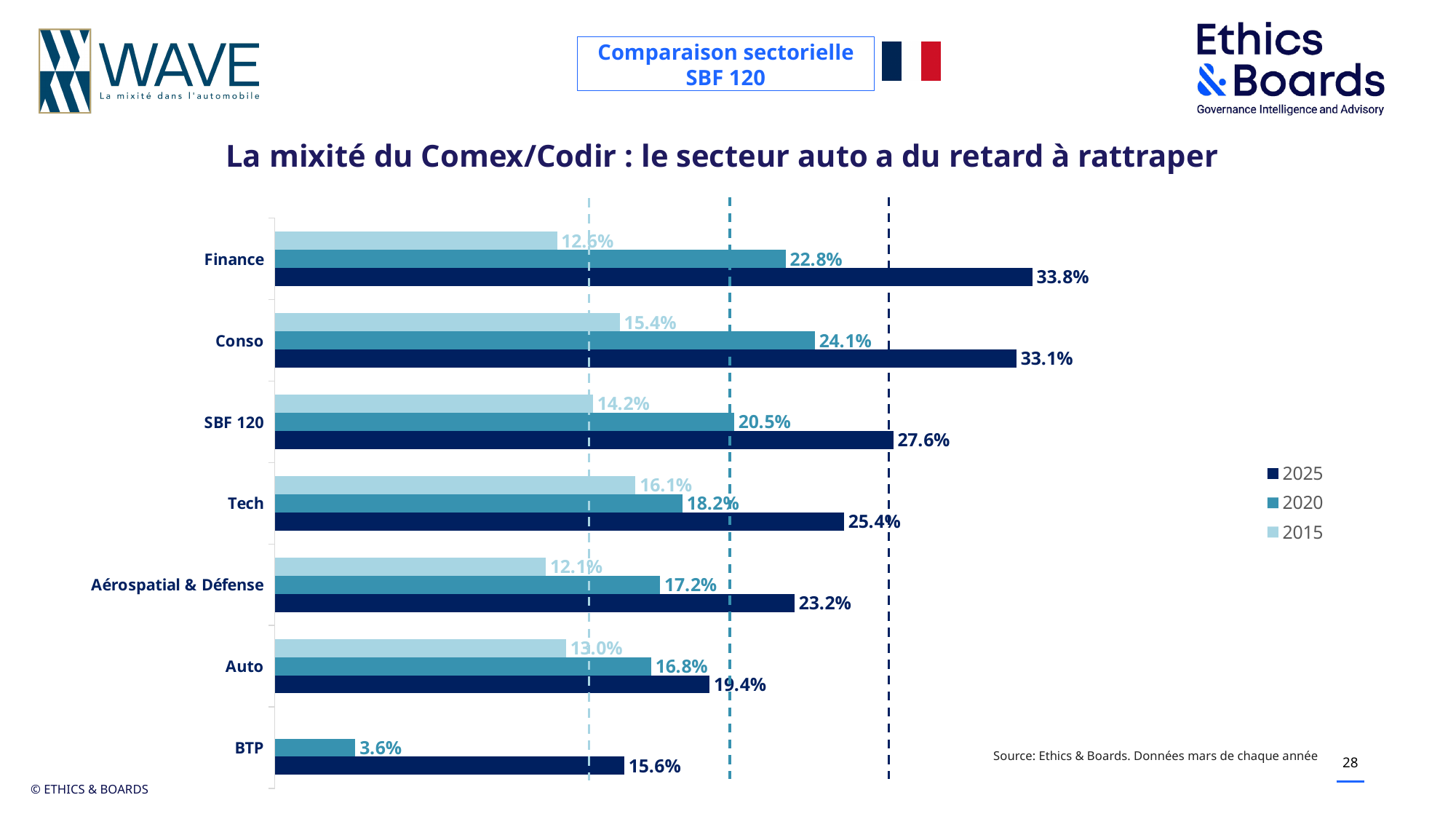
What is the difference between the 2025 and 2020 values for Auto? 2.6% What is the difference between the 2025 values for Finance and Auto? 14.4% Which is larger, the 2020 value for Conso or the 2020 value for Tech? Conso How many categories are shown on the chart? 7 What is the 2015 value for Aérospatial & Défense? 12.1% What is the 2025 value for Finance? 33.8% Which category has the highest 2025 value? Finance Which category has the lowest 2020 value? BTP What is the 2020 value for Auto? 16.8% What kind of chart is shown on the slide? Bar chart What is the 2025 value for SBF 120? 27.6% How many series does the legend list? 3